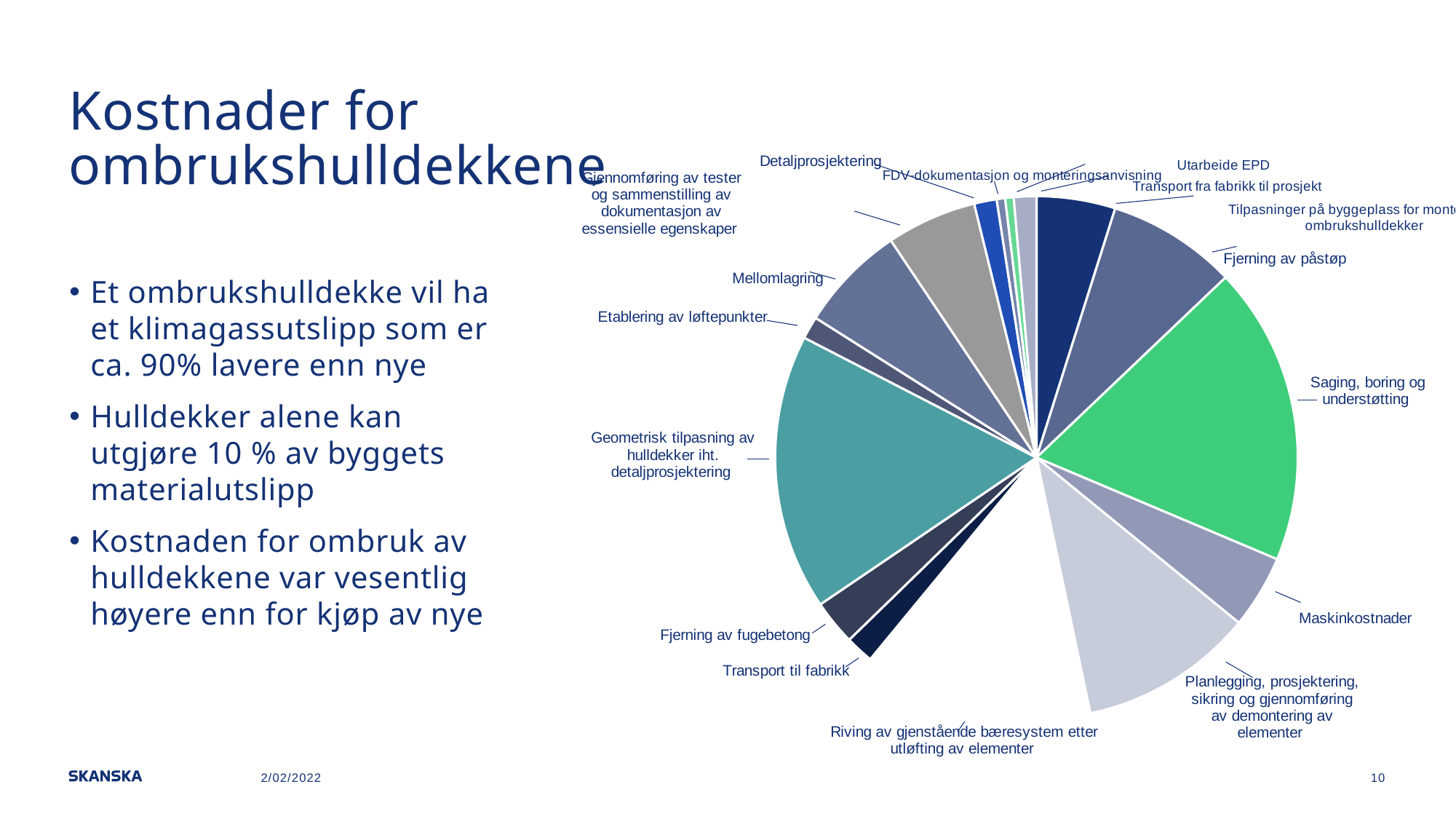
Which slice is larger: "Planlegging, prosjektering, sikring og gjennomføring av demontering av elementer" or "Detaljprosjektering"? Planlegging, prosjektering, sikring og gjennomføring av demontering av elementer Which slice is larger: "Saging, boring og understøtting" or "Maskinkostnader"? Saging, boring og understøtting What is the title of the slide containing the pie chart? Kostnader for ombrukshulldekkene What kind of chart is shown on the slide? Pie chart Which slice is larger: "Geometrisk tilpasning av hulldekker iht. detaljprosjektering" or "Transport til fabrikk"? Geometrisk tilpasning av hulldekker iht. detaljprosjektering What colour is the slice labelled "Saging, boring og understøtting"? Green